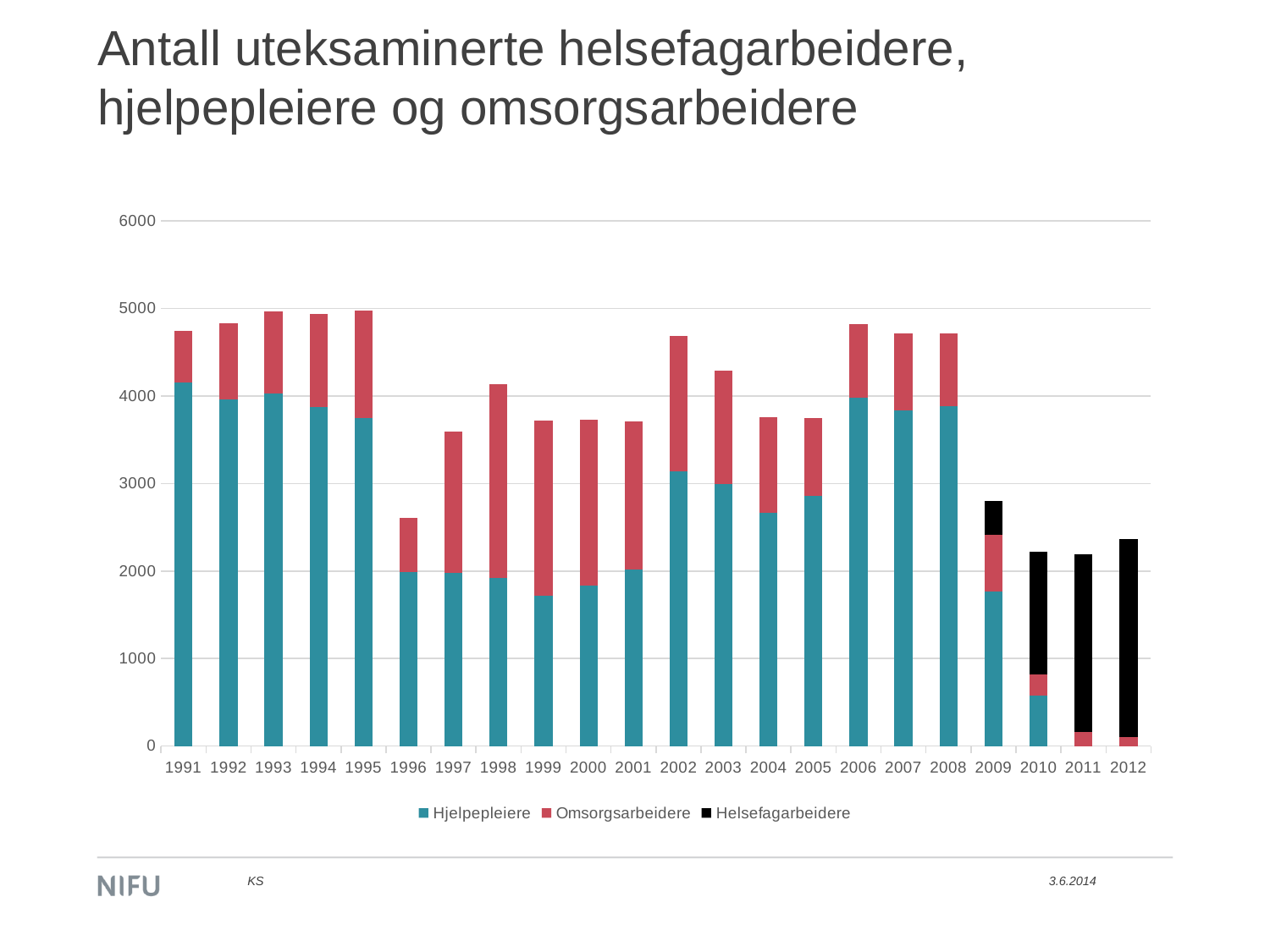
What kind of chart is shown on the slide? Stacked bar chart Is the Hjelpepleiere value for 2010 greater or less than 1000? less Is the total bar height for 1996 greater or less than 3000? less Which year has the taller total bar, 1995 or 1996? 1995 Do the total bar heights rise or fall from 2008 to 2012? fall What is the title of the slide? Antall uteksaminerte helsefagarbeidere, hjelpepleiere og omsorgsarbeidere How many series does the legend list? 3 Is the total bar height for 2012 greater or less than 2000? greater Which year has the larger Hjelpepleiere value, 1991 or 2009? 1991 How many years are shown along the x axis of the chart? 22 Which series is shown in black in the chart? Helsefagarbeidere